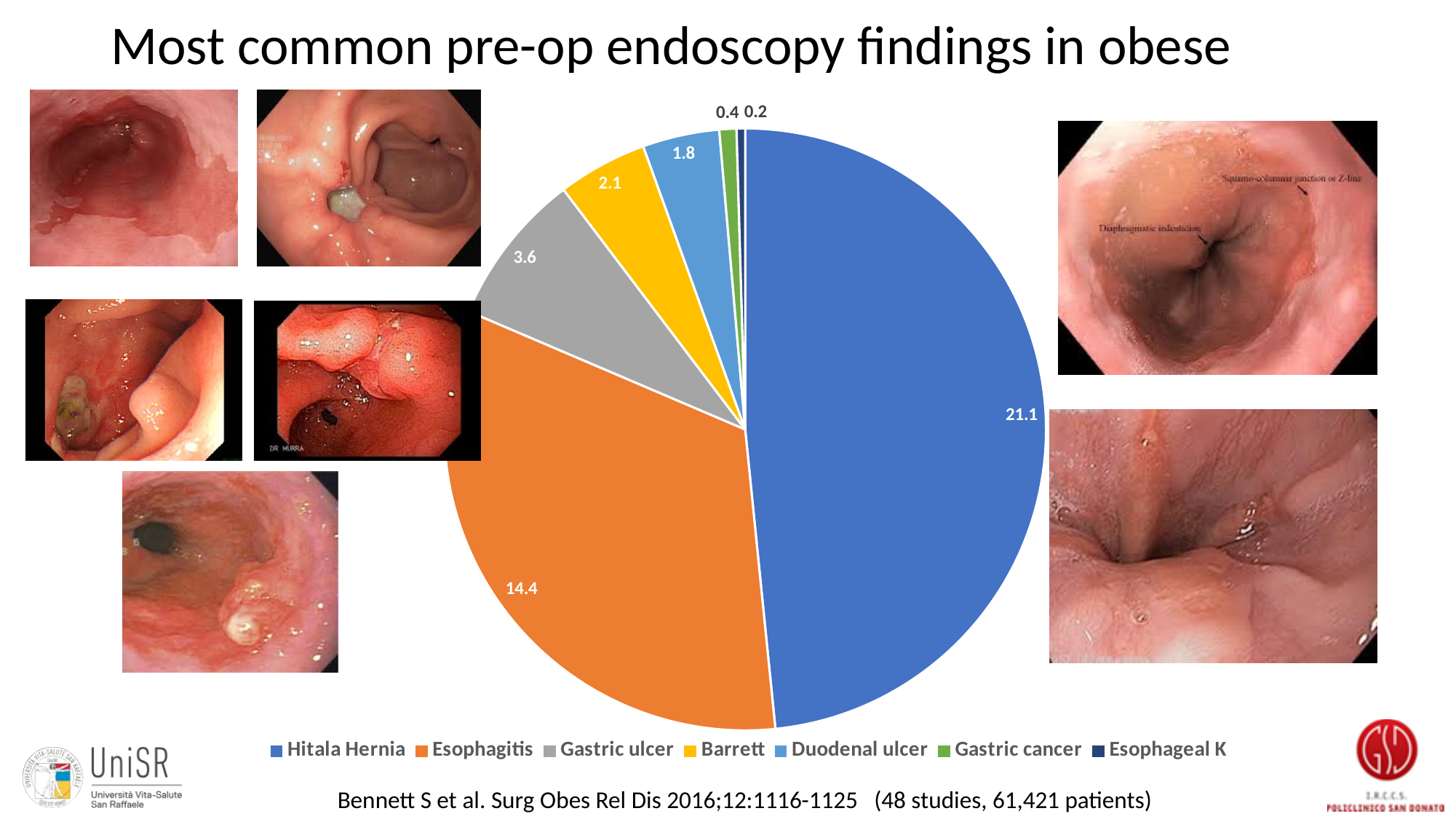
Which is larger, the value for Barrett or the value for Duodenal ulcer? Barrett What type of chart is shown on the slide? pie chart What is the value shown for Gastric ulcer? 3.6 What is the value shown for Hitala Hernia? 21.1 Which finding has the largest slice of the pie? Hitala Hernia What is the value shown for Esophagitis? 14.4 How many categories does the legend of the pie chart list? 7 What is the value shown for Esophageal K? 0.2 What colour is the Esophagitis slice in the pie chart? orange What is the difference between the values for Hitala Hernia and Esophagitis? 6.7 What is the value shown for Duodenal ulcer? 1.8 Which finding has the smallest slice of the pie? Esophageal K